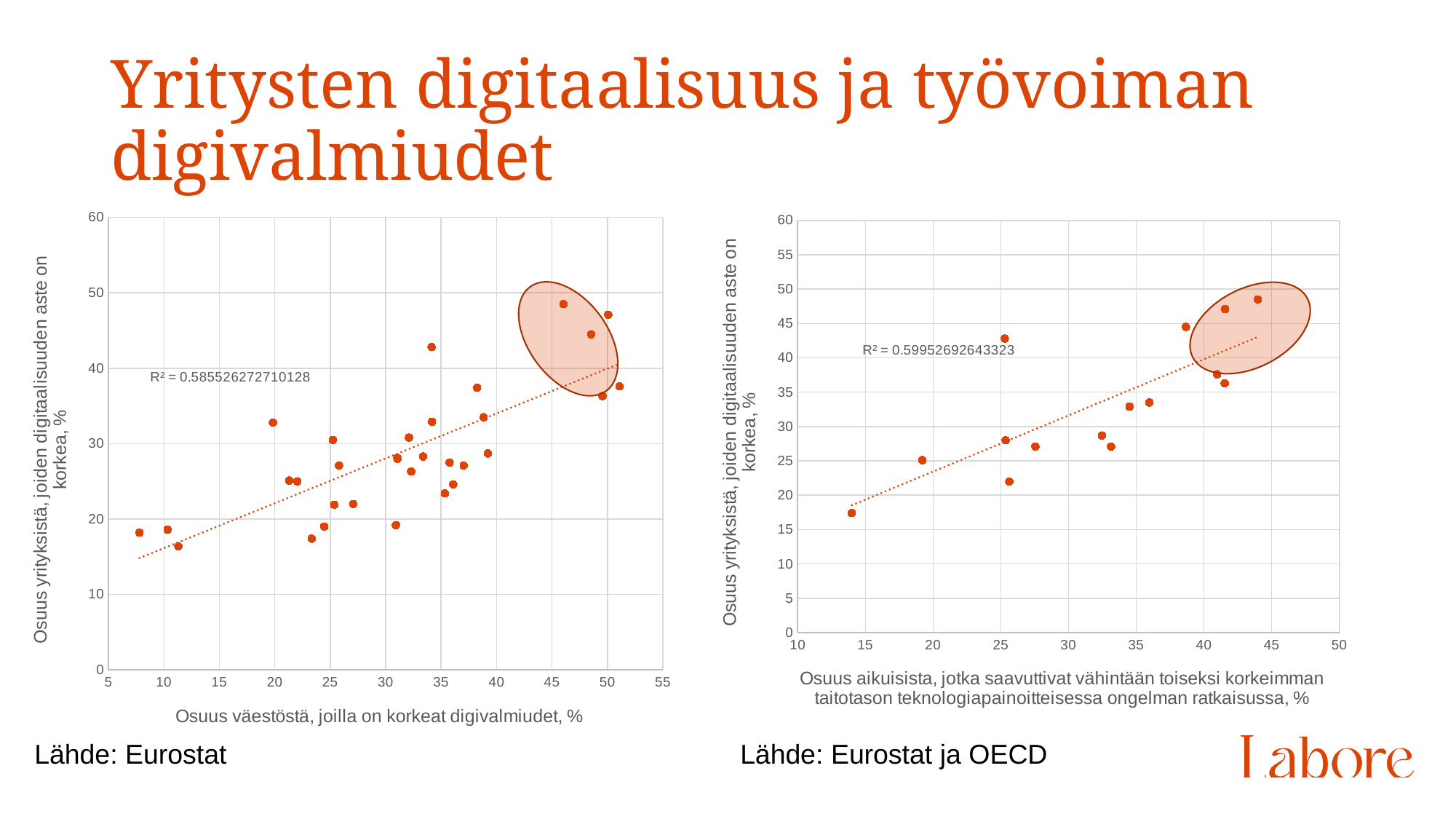
What is the x-axis label of the left chart? Osuus väestöstä, joilla on korkeat digivalmiudet, % In the left chart, do the plotted values generally rise or fall as the x-axis value increases? rise In the right chart, do the plotted values generally rise or fall as the x-axis value increases? rise In the left chart, is the y value of the leftmost point (at about 8 on the x axis) greater or less than 20? less What is the maximum value shown on the y axis of the right chart? 60 In the right chart, what R² value is printed next to the trend line? R² = 0.59952692643323 In the right chart, is the y value of the leftmost point (at about 14 on the x axis) greater or less than 20? less What kind of chart is the right chart on the slide? scatter chart In the left chart, what R² value is printed next to the trend line? R² = 0.585526272710128 What kind of chart is the left chart on the slide? scatter chart In the right chart, is the y value of the highest point inside the circled area greater or less than 45? greater